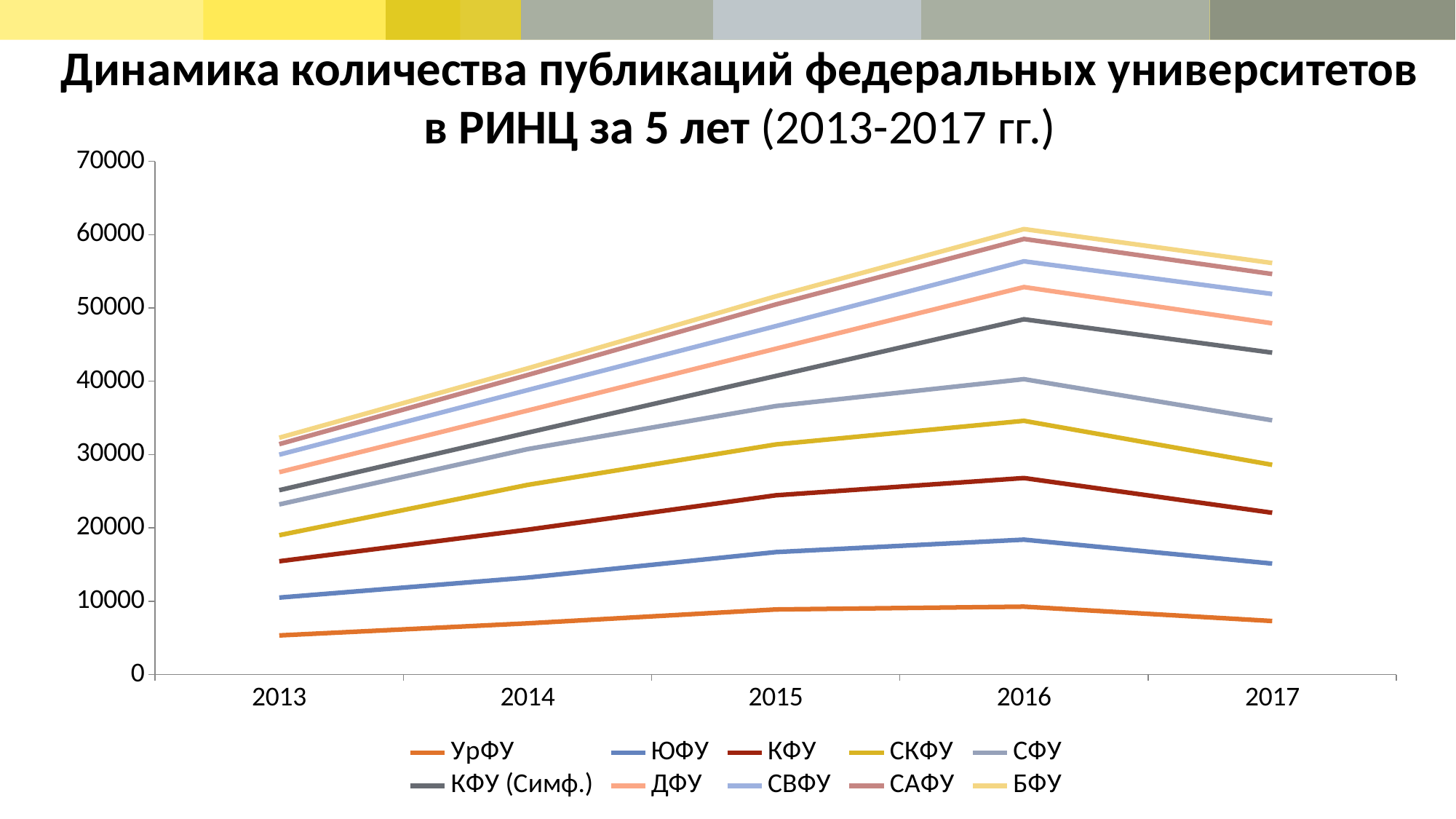
Does the УрФУ line rise or fall from 2013 to 2016? rise What kind of chart is shown on the slide? line chart How many series does the legend list? 10 Is the value of the КФУ (Симф.) line in 2013 greater or less than 30000? less Is the value of the БФУ line in 2016 greater or less than 50000? greater Is the value of the ЮФУ line in 2016 greater or less than 10000? greater In 2016, which line is higher, УрФУ or ЮФУ? ЮФУ In which year does the БФУ line reach its highest point? 2016 Does the СКФУ line rise or fall from 2016 to 2017? fall Which year is the first on the x axis? 2013 How many years are plotted along the x axis? 5